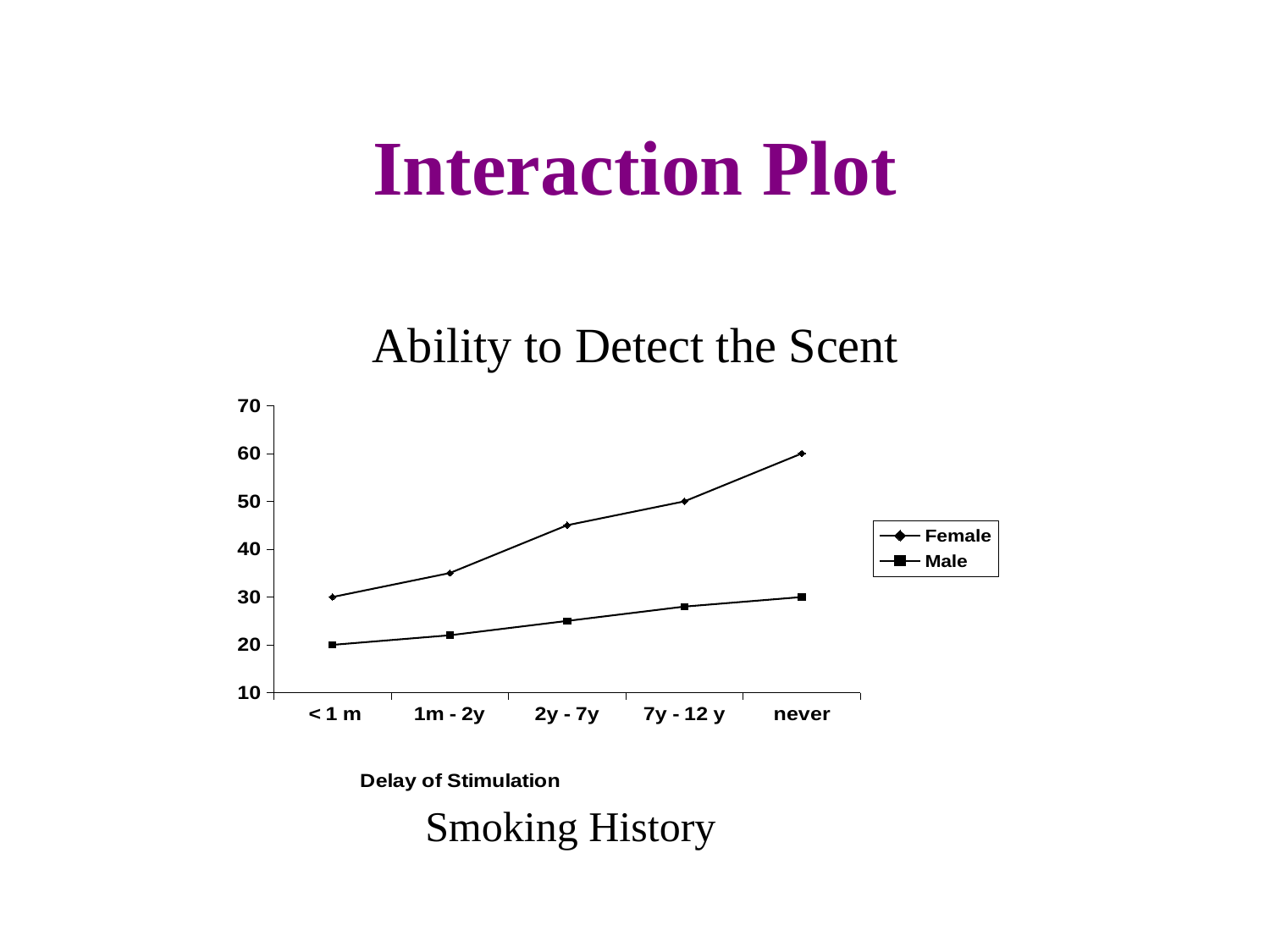
What is the Male value for the '< 1 m' category? 20 Which category has the highest Female value? never How many categories are shown on the x axis? 5 What is the Female value for the '< 1 m' category? 30 What is the Male value for the 'never' category? 30 Which category has the lowest Male value? < 1 m What kind of chart is shown on the slide? line chart What is the Female value for the 'never' category? 60 How many series does the legend list? 2 What is the difference between the Female and Male values for the 'never' category? 30 Do the Male values rise or fall from '< 1 m' to 'never'? rise Is the Female value for '2y - 7y' greater or less than 40? greater